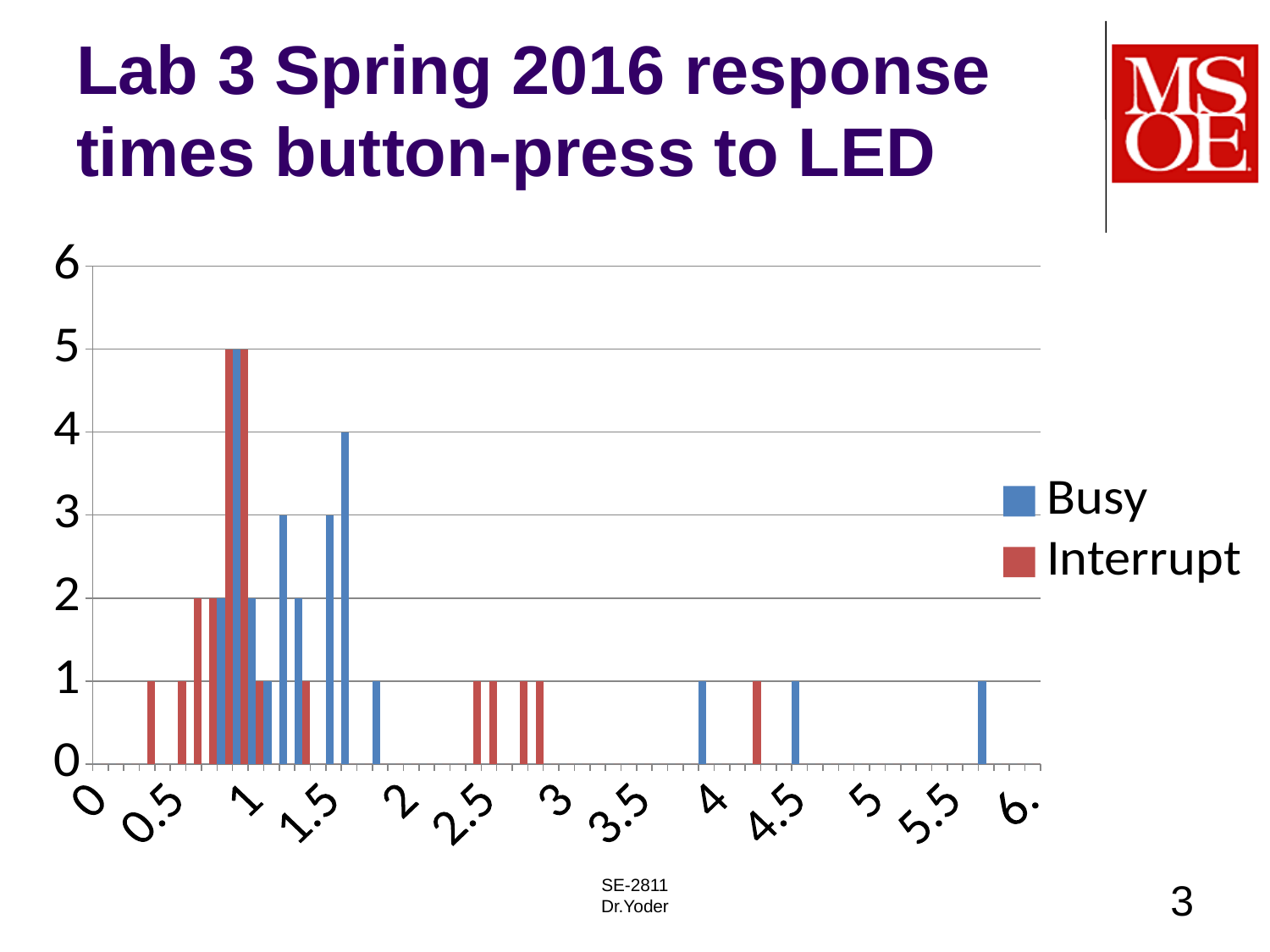
What is the value of the Busy bar located at about 4 on the horizontal axis? 1 What kind of chart is shown on the slide? bar chart What is the title of the chart on the slide? Lab 3 Spring 2016 response times button-press to LED What is the largest value labelled on the horizontal axis? 6 Is the tallest bar in the chart greater or less than 6? less What is the value of the tallest bar in the chart? 5 What are the two series named in the legend? Busy and Interrupt What is the value of the Interrupt bar located between 4 and 4.5 on the horizontal axis? 1 What is the highest value shown on the vertical axis? 6 Which series has a bar beyond 5.5 on the horizontal axis, Busy or Interrupt? Busy What is the value of the Busy bar located just past 5.5 on the horizontal axis? 1 How many series does the legend list? 2